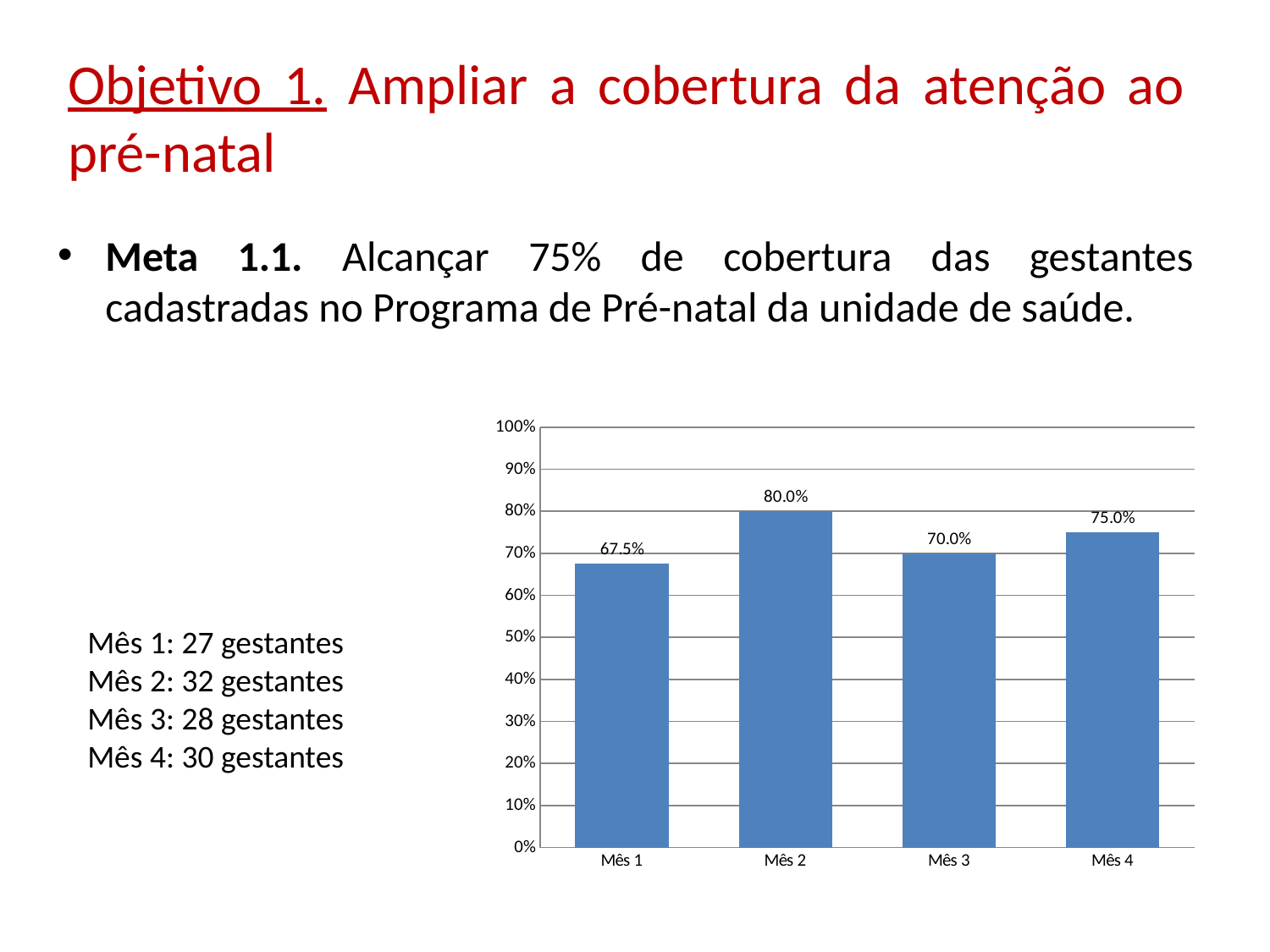
What is the difference between the values for Mês 2 and Mês 1? 12.5% What kind of chart is shown on the slide? bar chart Which month has the highest value? Mês 2 How many categories are shown on the x axis? 4 Is the value for Mês 2 greater or less than 70%? greater What is the value for Mês 2? 80.0% What is the value for Mês 1? 67.5% Which is larger, the value for Mês 3 or the value for Mês 4? Mês 4 What is the difference between the values for Mês 4 and Mês 3? 5.0% Which month has the lowest value? Mês 1 What is the value for Mês 3? 70.0% What is the value for Mês 4? 75.0%